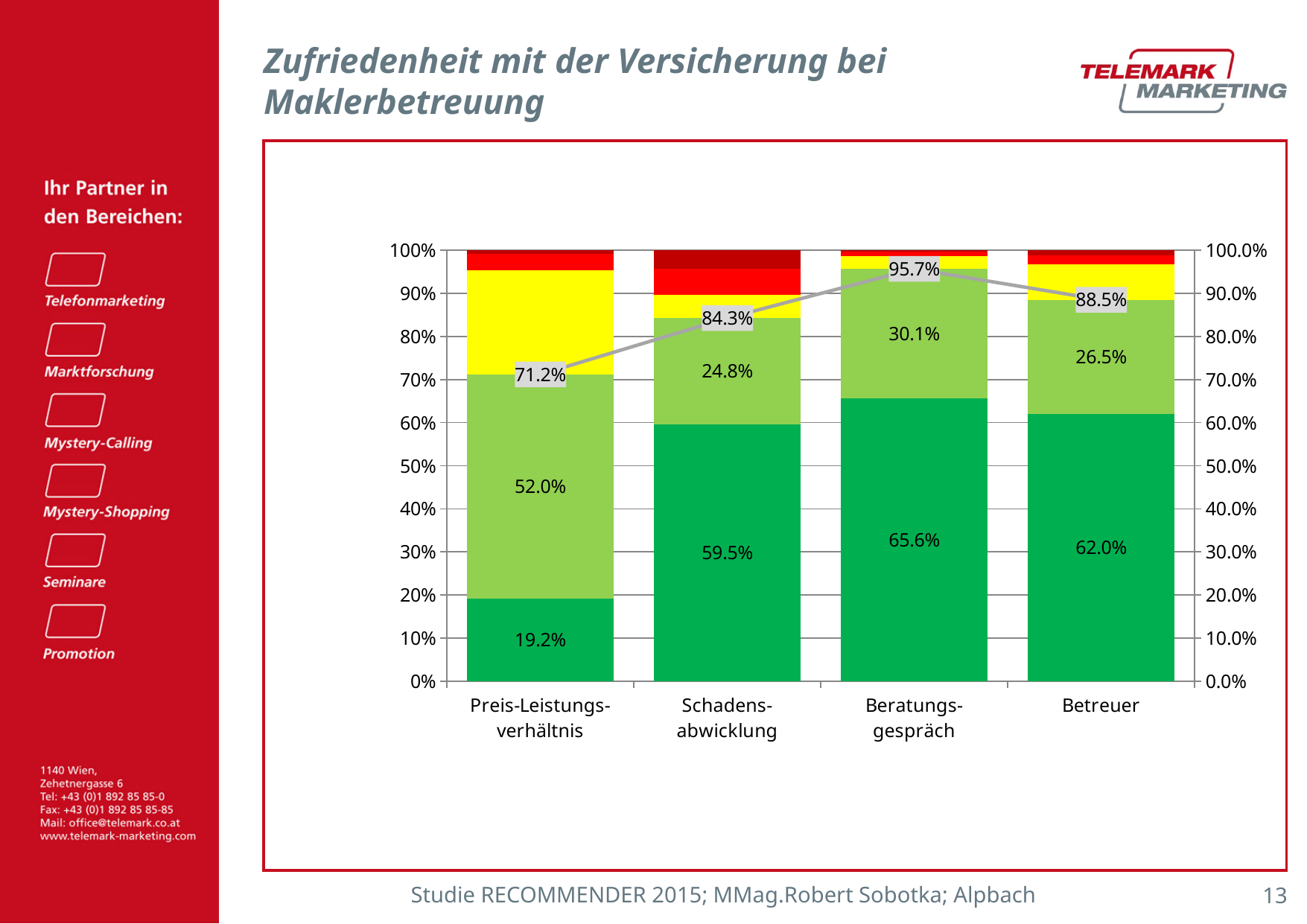
What is the value of the bottom (dark green) segment for Schadensabwicklung? 59.5% What kind of chart is shown on the slide? Stacked bar chart with a line overlay What is the value of the bottom (dark green) segment for Preis-Leistungsverhältnis? 19.2% What is the combined value of the dark green and light green segments for Preis-Leistungsverhältnis? 71.2% Which has the larger bottom (dark green) segment: Beratungsgespräch or Betreuer? Beratungsgespräch For which category does the line reach its highest value? Beratungsgespräch What is the value of the light green segment for Preis-Leistungsverhältnis? 52.0% How many categories are shown on the x axis of the chart? 4 For which category is the line value lowest? Preis-Leistungsverhältnis What value does the line show for Betreuer? 88.5% What is the difference between the highest and lowest line values (95.7% and 71.2%)? 24.5 percentage points What is the title of the slide containing the chart? Zufriedenheit mit der Versicherung bei Maklerbetreuung